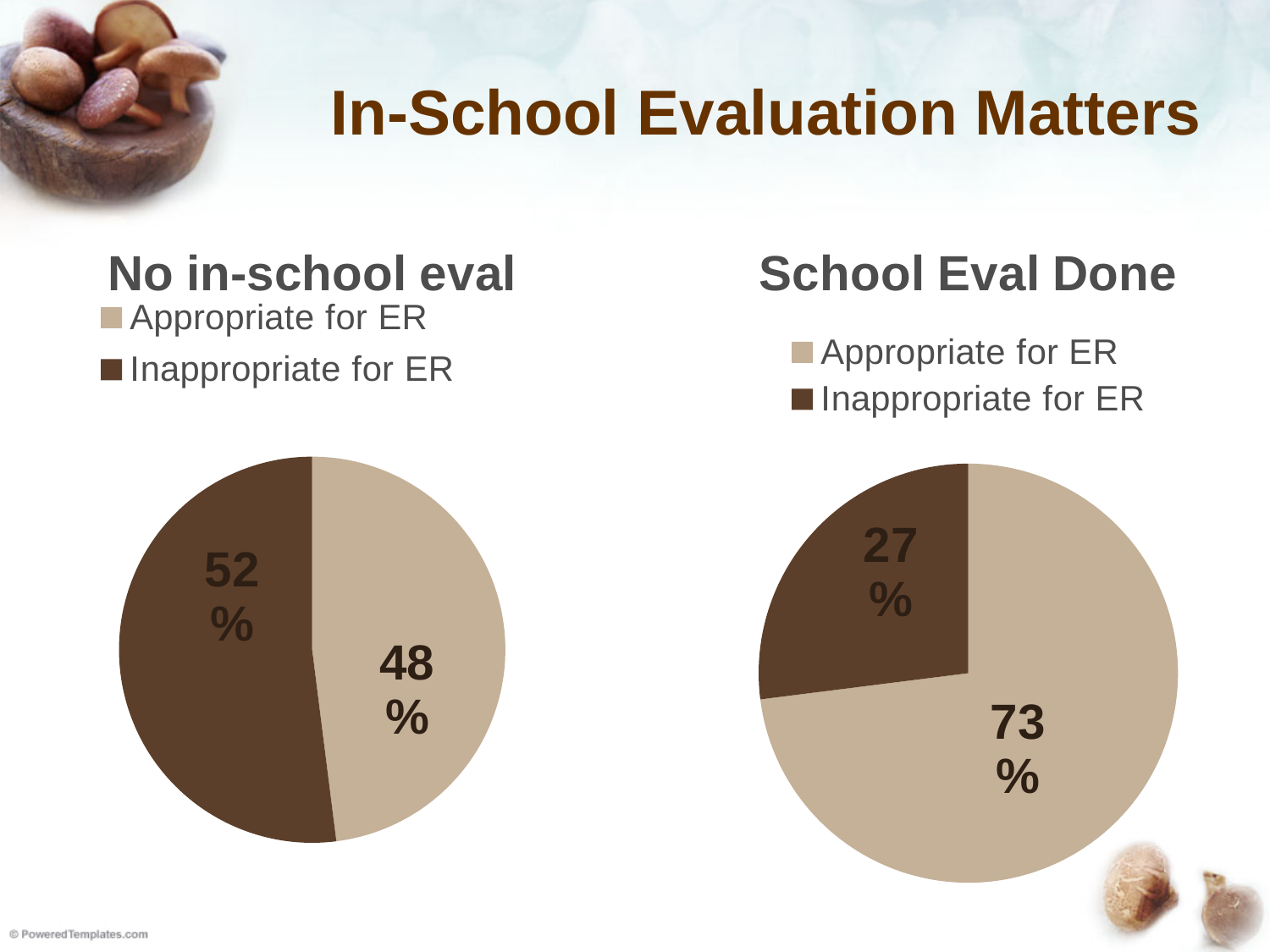
How many categories does the 'School Eval Done' chart show? 2 In the 'School Eval Done' chart, what is the difference between the Appropriate for ER and Inappropriate for ER shares? 46% In the 'School Eval Done' chart, what share is Appropriate for ER? 73% In the 'School Eval Done' chart, what share is Inappropriate for ER? 27% In the 'No in-school eval' chart, what share is Appropriate for ER? 48% How many entries does the legend of the 'No in-school eval' chart list? 2 Is the Appropriate for ER share larger in the 'No in-school eval' chart or the 'School Eval Done' chart? School Eval Done In the 'School Eval Done' chart, which colour represents Inappropriate for ER? Dark brown In the 'No in-school eval' chart, what share is Inappropriate for ER? 52% What type of chart is the 'No in-school eval' chart? Pie chart In the 'No in-school eval' chart, which category has the smallest slice? Appropriate for ER In the 'School Eval Done' chart, which category has the largest slice? Appropriate for ER